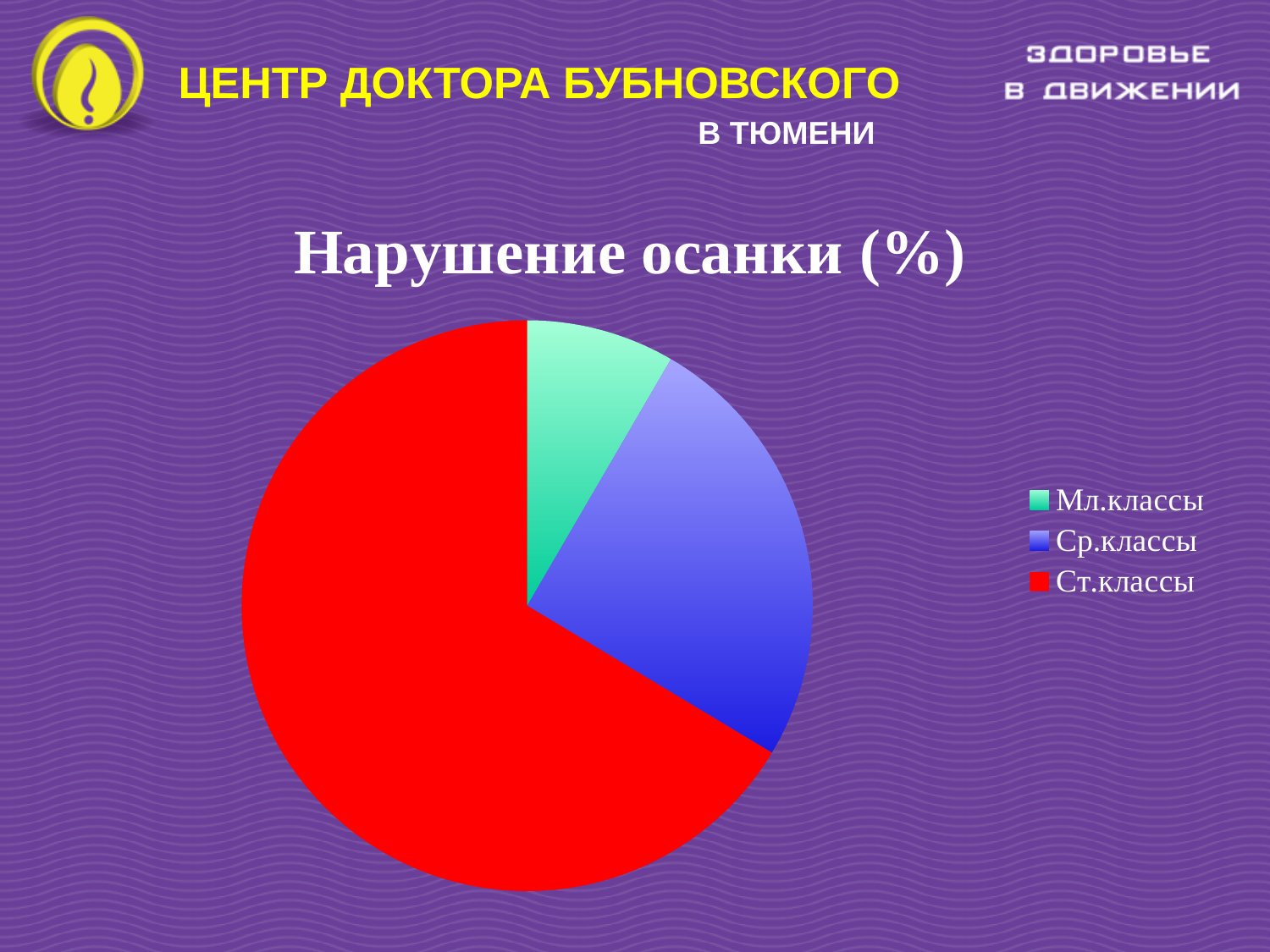
What kind of chart is shown on the slide? pie chart What is the title of the chart? Нарушение осанки (%) What colour is the slice for Ст.классы? red Does the Ст.классы slice take up more or less than half of the pie? more Which slice is larger, Ср.классы or Мл.классы? Ср.классы Which category has the largest slice of the pie? Ст.классы Which slice is larger, Ст.классы or Ср.классы? Ст.классы How many entries does the legend list? 3 How many slices does the pie chart have? 3 Which category has the smallest slice of the pie? Мл.классы